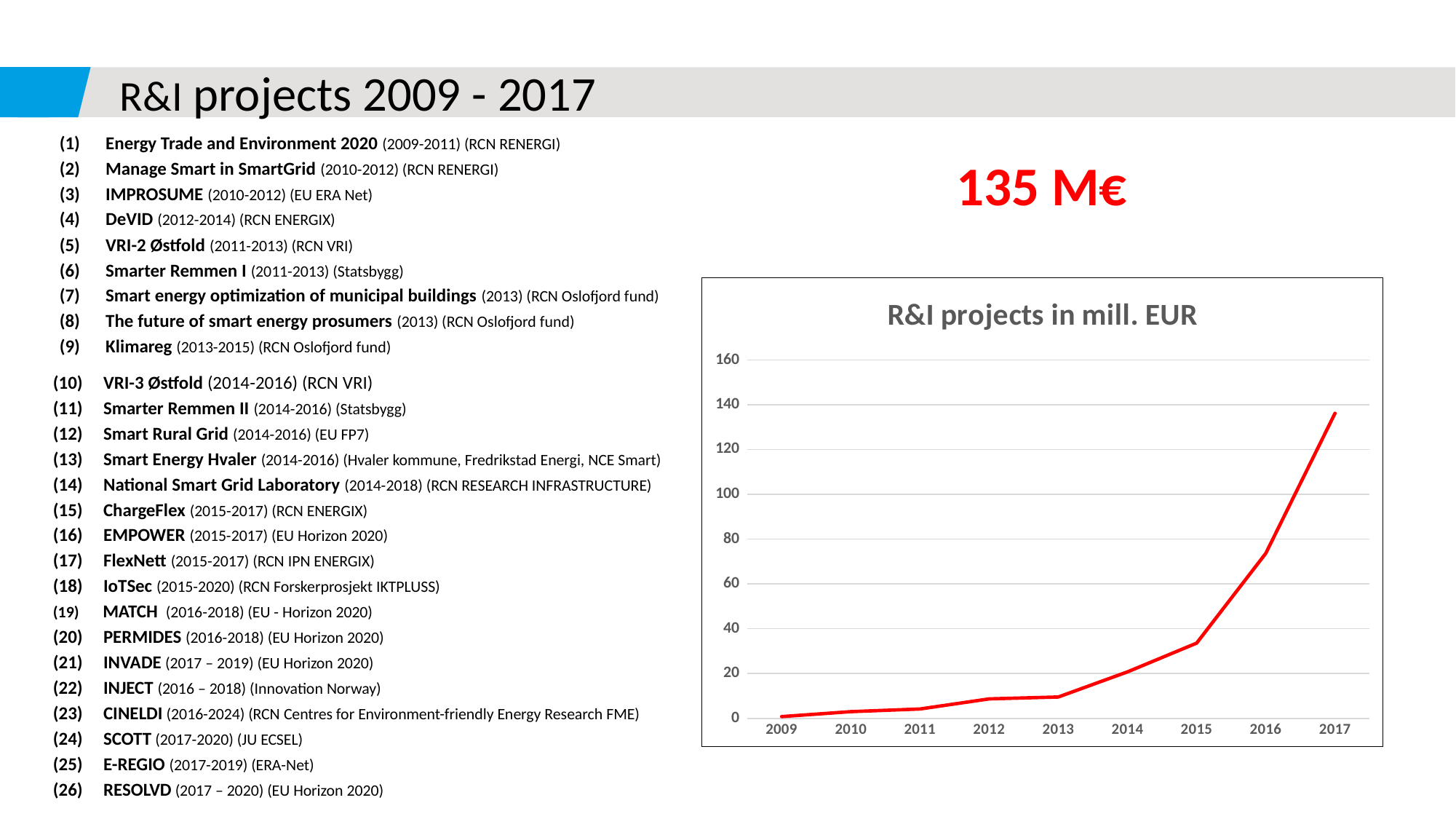
Is the value for 2015 greater or less than 40? less Do the values in the chart rise or fall from 2009 to 2017? rise Which year has the larger value, 2015 or 2016? 2016 Is the value for 2016 greater or less than 60? greater Is the value for 2013 greater or less than 20? less How many years are plotted on the x axis of the chart? 9 Which year has the lowest value in the chart? 2009 What is the title of the chart? R&I projects in mill. EUR Which year has the highest value in the chart? 2017 What kind of chart is shown on the slide? line chart